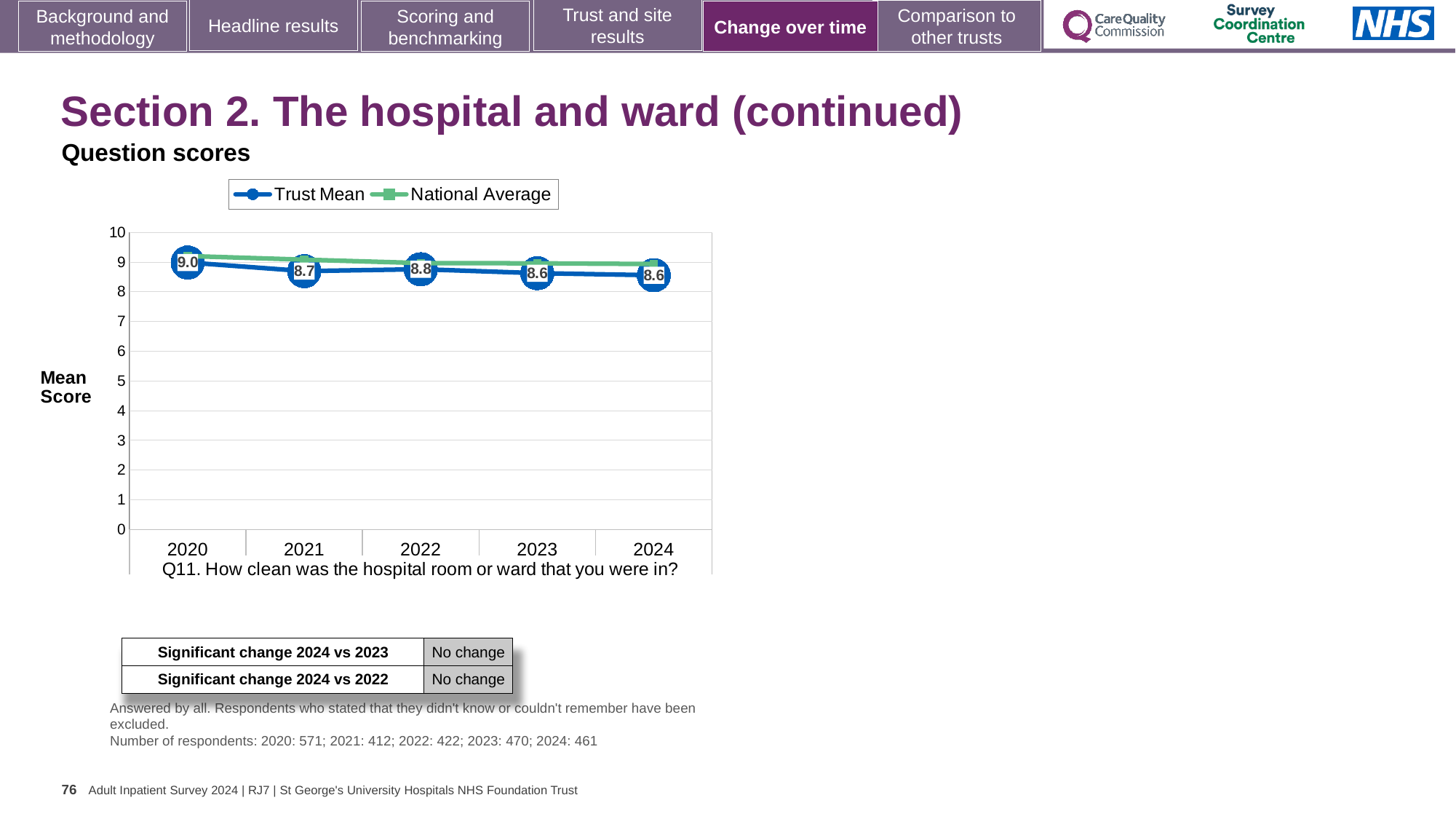
In which year is the Trust Mean score highest? 2020 Is the National Average value for 2024 greater or less than 8? greater Does the Trust Mean score generally rise or fall from 2020 to 2024? Fall What is the Trust Mean score for 2020? 9.0 What is the Trust Mean score for 2024? 8.6 How many years are plotted on the x axis? 5 What is the Trust Mean score for 2022? 8.8 Which is larger, the Trust Mean score in 2020 or in 2021? 2020 In 2024, which series is higher, Trust Mean or National Average? National Average How many series does the legend list? 2 What kind of chart is shown on the slide? Line chart What is the difference between the Trust Mean score in 2020 and in 2024? 0.4